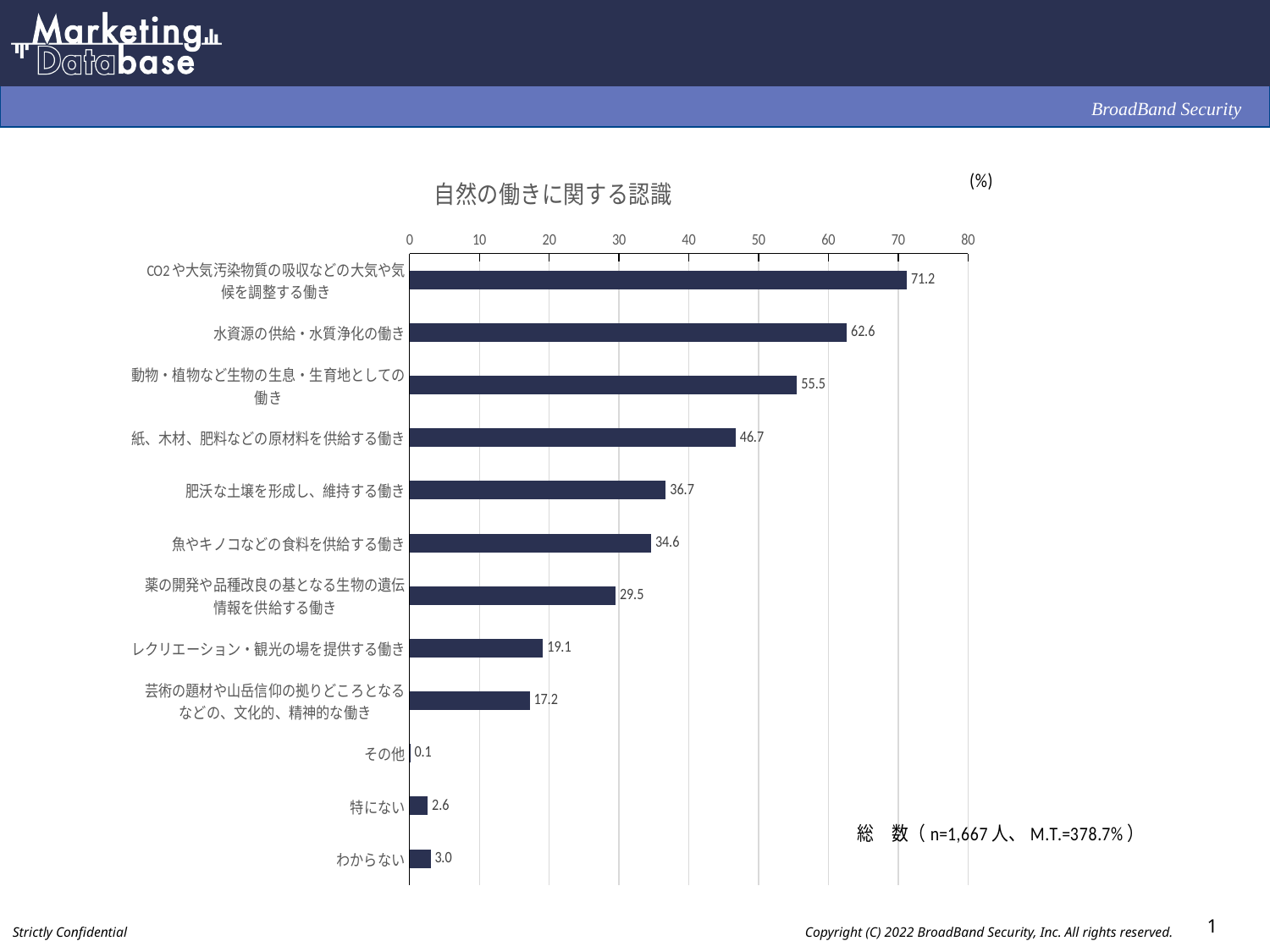
What kind of chart is shown on the slide? bar chart How many categories are shown in the chart? 12 What is the sample size (n) shown on the slide? 1,667 What is the difference between the values for 動物・植物など生物の生息・生育地としての働き and 紙、木材、肥料などの原材料を供給する働き? 8.8 Which is larger: the value for 特にない or the value for わからない? わからない What is the title of the chart? 自然の働きに関する認識 What is the value for 肥沃な土壌を形成し、維持する働き? 36.7 Which category has the highest value? CO2や大気汚染物質の吸収などの大気や気候を調整する働き What is the value for レクリエーション・観光の場を提供する働き? 19.1 What is the value for 水資源の供給・水質浄化の働き? 62.6 Which category has the lowest value? その他 Is the value for 薬の開発や品種改良の基となる生物の遺伝情報を供給する働き greater or less than 30? less